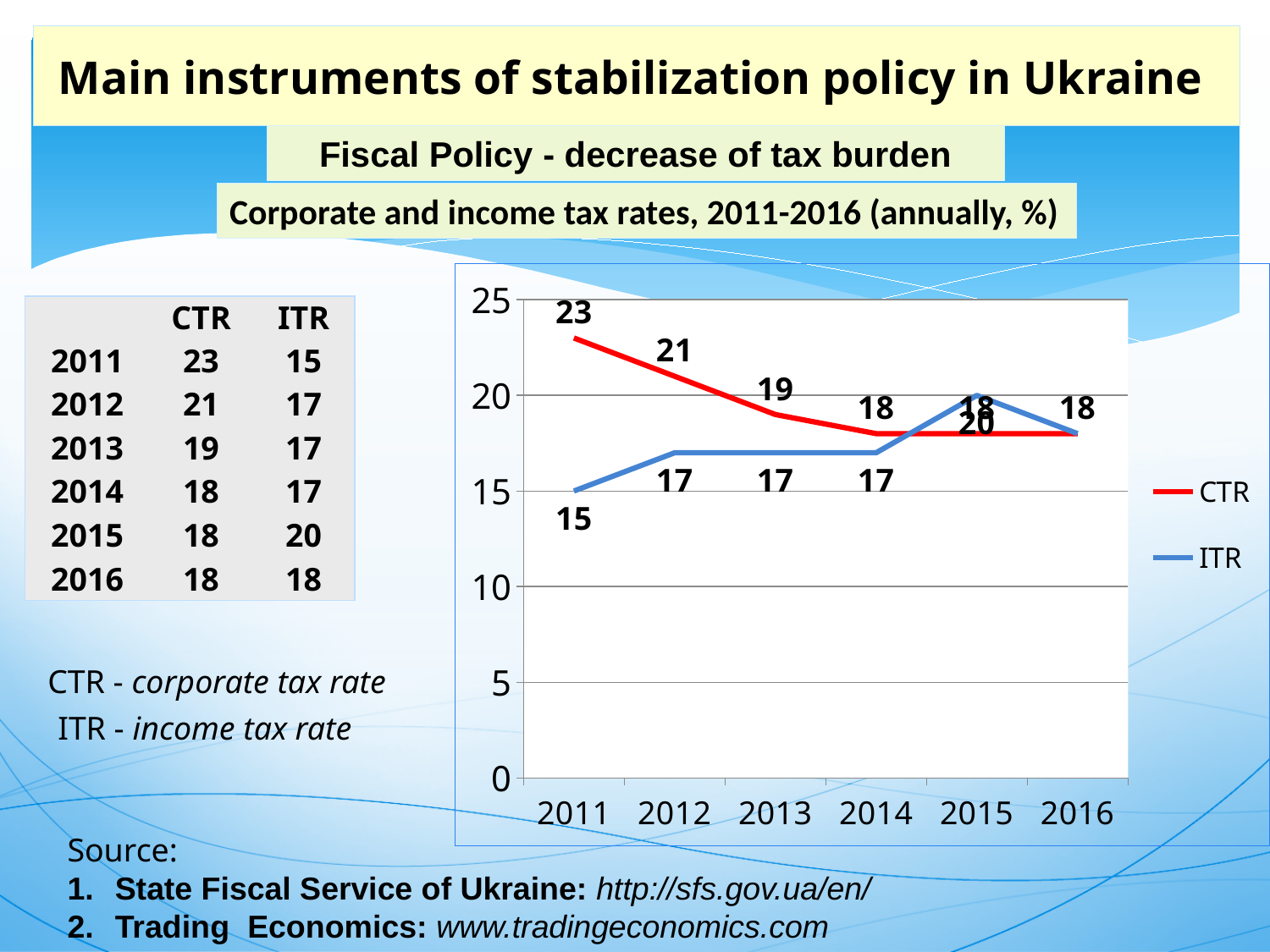
What is the ITR value for 2015? 20 What is the CTR value for 2011? 23 How many series does the legend list? 2 How many years are shown on the x axis? 6 Does the CTR rise or fall from 2011 to 2014? fall What is the difference between the CTR and ITR values in 2011? 8 What kind of chart is shown? line chart Is the CTR value for 2012 greater or less than 20? greater Which is larger in 2015, CTR or ITR? ITR In which year is the CTR highest? 2011 What is the CTR value for 2013? 19 In which year is the ITR lowest? 2011